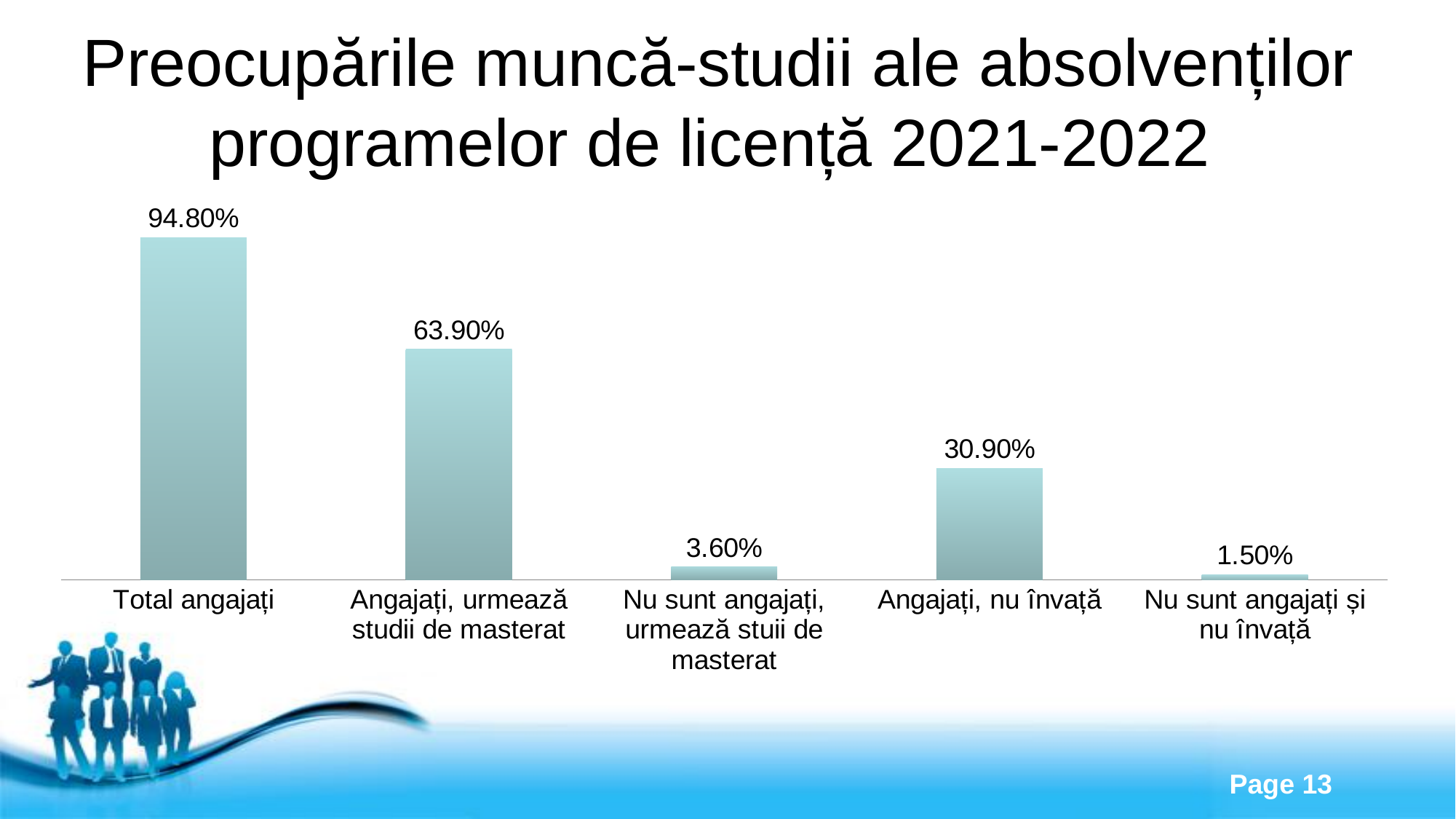
Which category has the highest value? Total angajați What kind of chart is shown on the slide? Bar chart How many categories are shown in the chart? 5 What is the value for "Total angajați"? 94.80% What is the value for "Nu sunt angajați, urmează stuii de masterat"? 3.60% What is the value for "Angajați, urmează studii de masterat"? 63.90% What is the difference between the values for "Angajați, urmează studii de masterat" and "Angajați, nu învață"? 33.00% What is the title of the slide containing the chart? Preocupările muncă-studii ale absolvenților programelor de licență 2021-2022 Which is larger: the value for "Nu sunt angajați, urmează stuii de masterat" or the value for "Nu sunt angajați și nu învață"? Nu sunt angajați, urmează stuii de masterat What is the value for "Nu sunt angajați și nu învață"? 1.50% Which category has the lowest value? Nu sunt angajați și nu învață What is the value for "Angajați, nu învață"? 30.90%